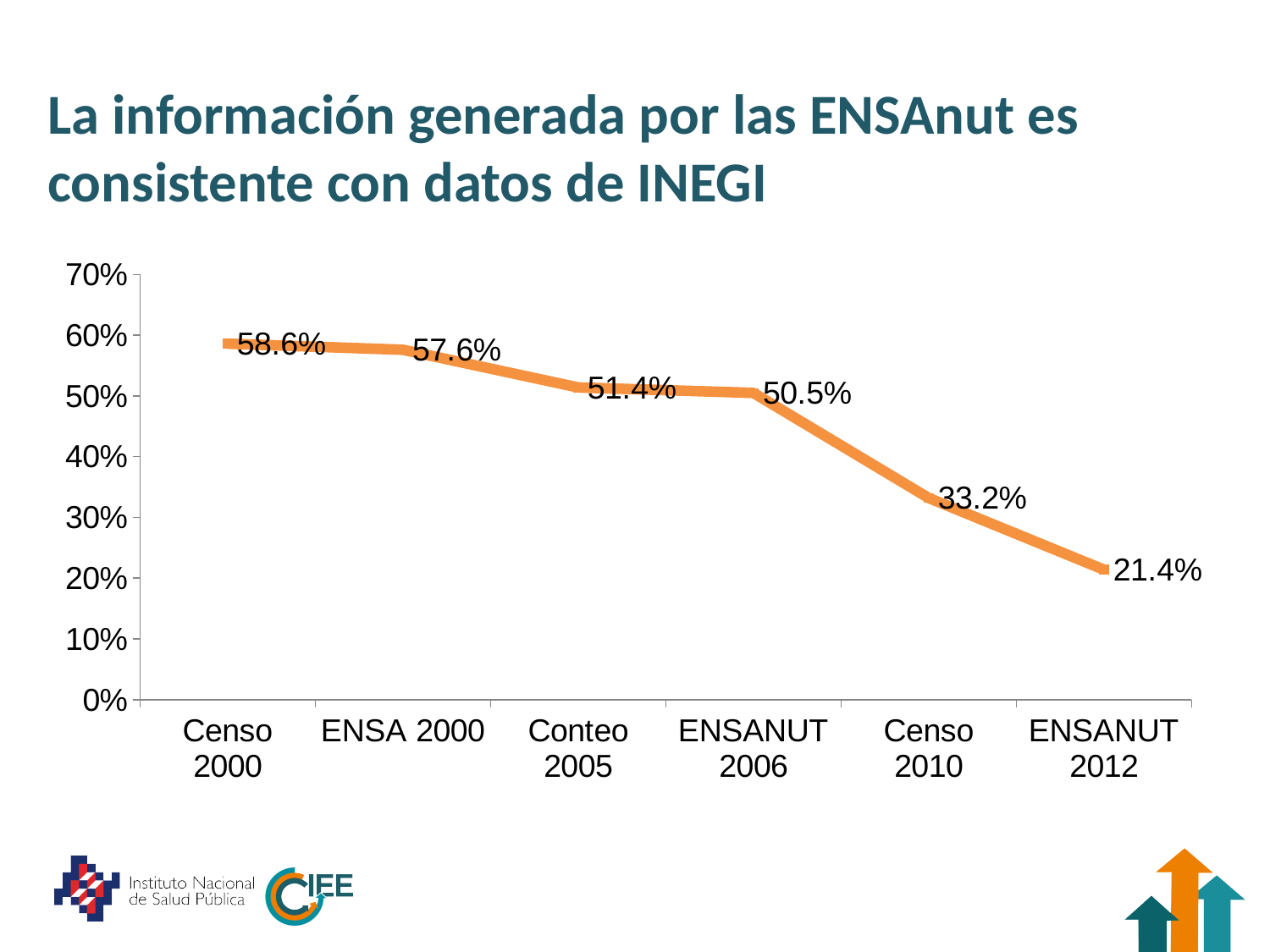
What is the value for Censo 2010? 33.2% What kind of chart is shown on the slide? Line chart How many data points are plotted on the chart? 6 Do the values rise or fall from Censo 2000 to ENSANUT 2012? Fall Which category has the highest value? Censo 2000 Which category has the lowest value? ENSANUT 2012 Which is larger, the value for ENSA 2000 or the value for ENSANUT 2006? ENSA 2000 What is the difference between the values for Censo 2010 and ENSANUT 2012? 11.8% What is the value for Conteo 2005? 51.4% What is the value for Censo 2000? 58.6% Is the value for ENSANUT 2006 greater or less than 40%? greater What is the value for ENSANUT 2012? 21.4%